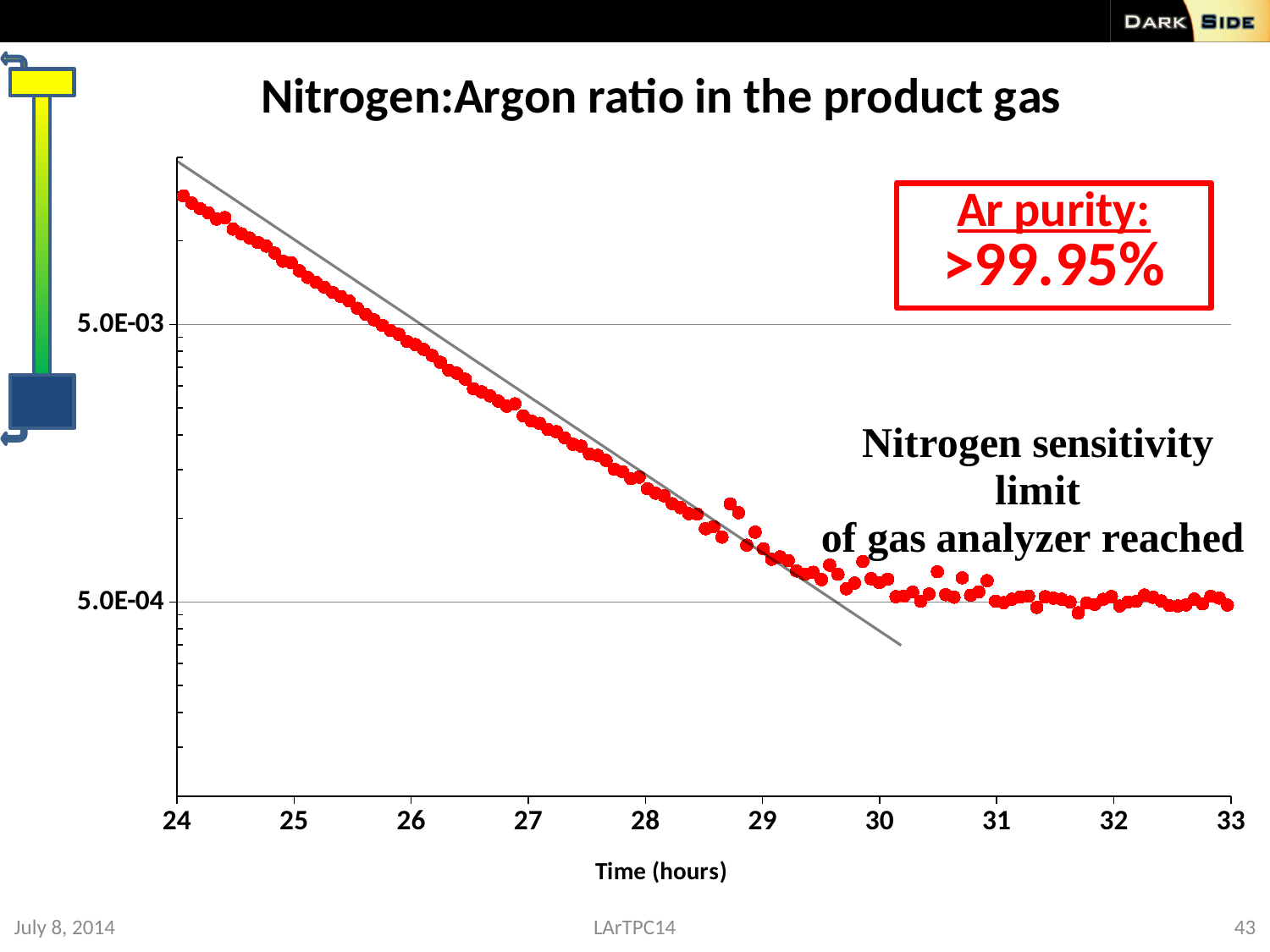
What is the lowest time value shown on the x axis? 24 What is the title of the chart? Nitrogen:Argon ratio in the product gas Do the plotted values rise or fall as time increases from 24 to 30 hours? fall Is the value at 28 hours greater or less than 5.0E-04? greater Is the value at 24 hours larger or smaller than the value at 31 hours? larger Is the value at 29 hours greater or less than 5.0E-04? greater What is the label of the x axis? Time (hours) Is the value at 27 hours greater or less than 5.0E-03? less How many labelled tick marks are on the x axis? 10 What kind of chart is shown on the slide? scatter chart